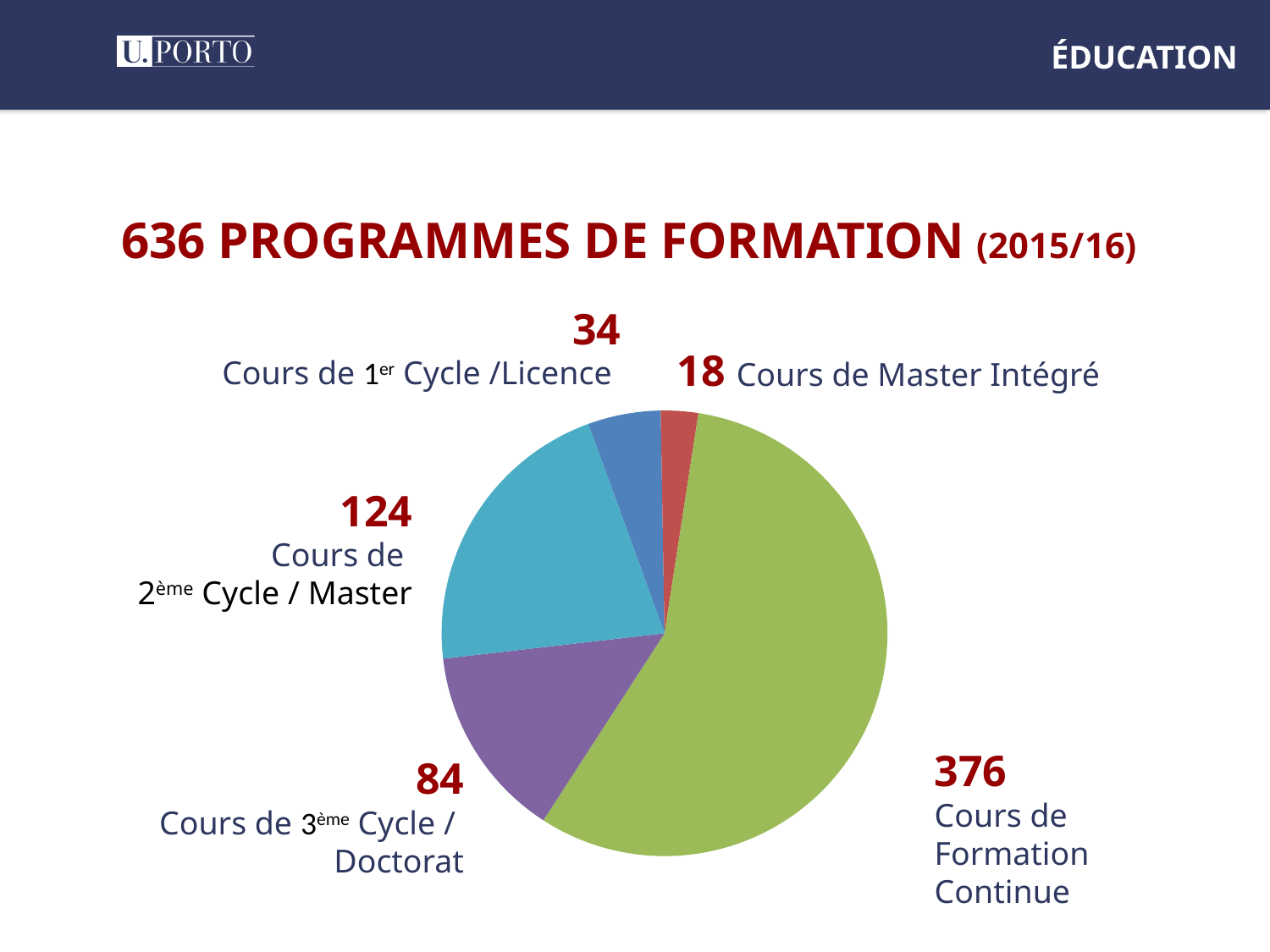
Which is larger, Cours de 1er Cycle / Licence or Cours de Master Intégré? Cours de 1er Cycle / Licence What is the value for Cours de Formation Continue? 376 What is the value for Cours de 3ème Cycle / Doctorat? 84 How many slices does the pie chart have? 5 What is the value for Cours de 2ème Cycle / Master? 124 Which category has the smallest slice of the pie? Cours de Master Intégré What is the difference between Cours de 2ème Cycle / Master and Cours de 3ème Cycle / Doctorat? 40 What is the total number of programmes across all slices of the pie? 636 What type of chart is shown on the slide? Pie chart What is the value for Cours de Master Intégré? 18 Which category has the largest slice of the pie? Cours de Formation Continue What is the title of the chart? 636 PROGRAMMES DE FORMATION (2015/16)